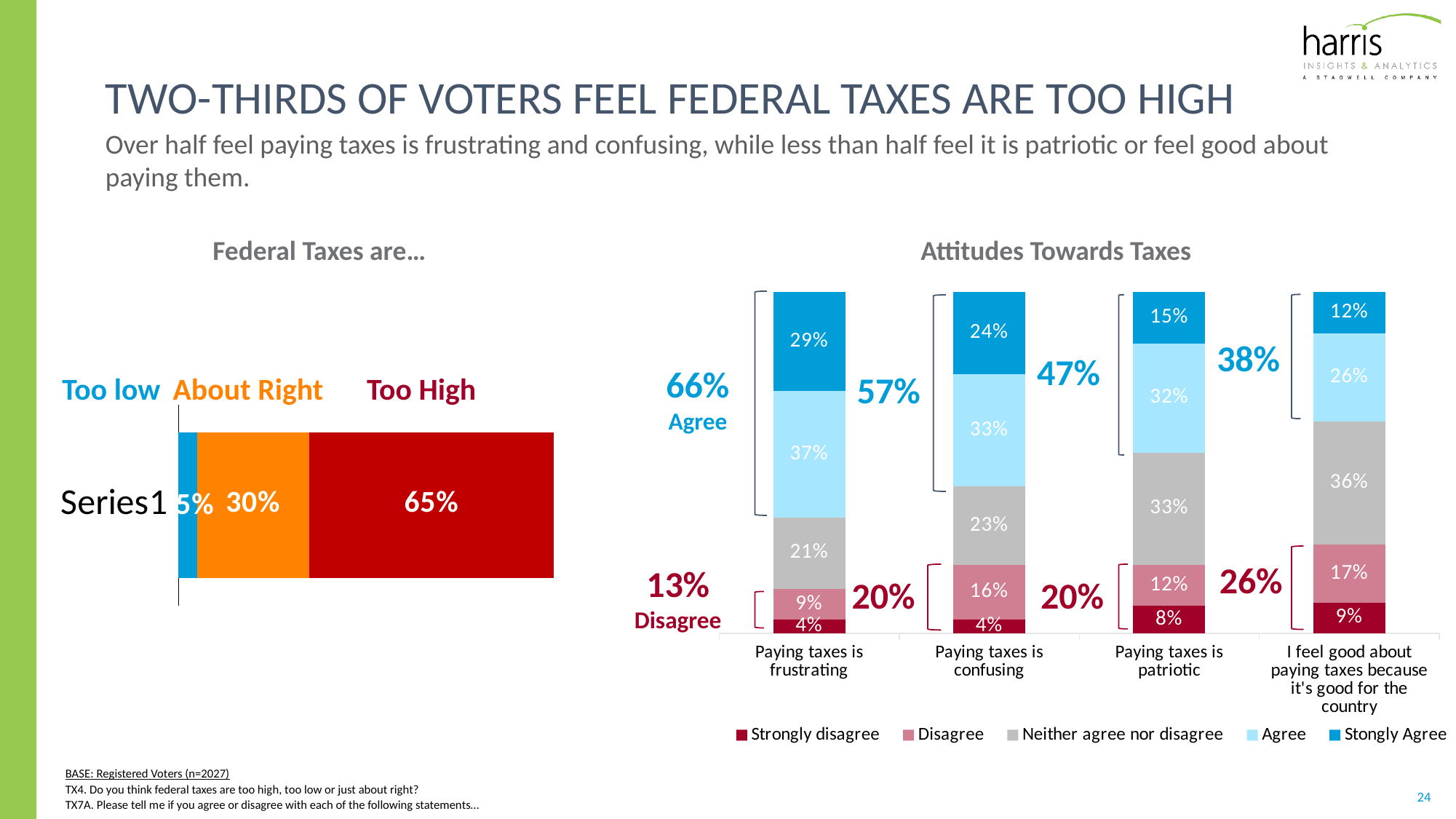
In the 'Attitudes Towards Taxes' chart, what percentage strongly agree that paying taxes is frustrating? 29% In the 'Federal Taxes are...' chart, what percentage of voters say federal taxes are Too High? 65% In the 'Attitudes Towards Taxes' chart, what percentage neither agree nor disagree that paying taxes is patriotic? 33% In the 'Attitudes Towards Taxes' chart, how many statements are shown on the x axis? 4 In the 'Attitudes Towards Taxes' chart, which statement has the highest total Agree percentage? Paying taxes is frustrating In the 'Attitudes Towards Taxes' chart, is the Agree value for 'Paying taxes is confusing' larger or smaller than the Agree value for 'Paying taxes is patriotic'? Larger In the 'Federal Taxes are...' chart, what is the difference between the Too High and About Right percentages? 35% In the 'Federal Taxes are...' chart, what percentage say federal taxes are About Right? 30% In the 'Attitudes Towards Taxes' chart, what percentage strongly disagree with 'I feel good about paying taxes because it's good for the country'? 9% In the 'Attitudes Towards Taxes' chart, how many series does the legend list? 5 In the 'Federal Taxes are...' chart, which response has the smallest share? Too low What kind of chart is the 'Federal Taxes are...' chart? Stacked bar chart